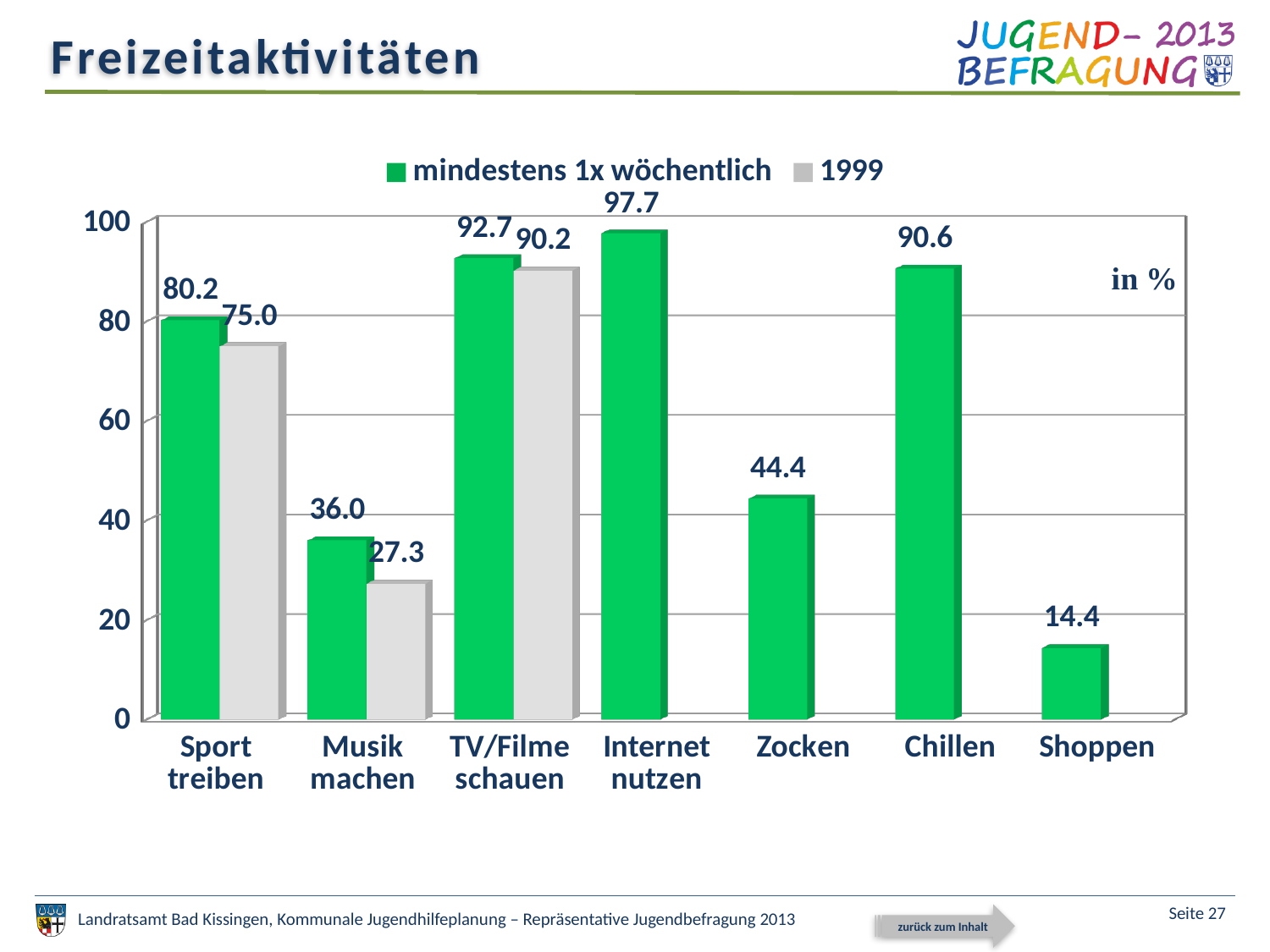
How many series does the legend list? 2 What kind of chart is shown on the slide? bar chart Is the value for 'Zocken' greater or less than 40? greater Which is larger for 'TV/Filme schauen': the 'mindestens 1x wöchentlich' value or the 1999 value? mindestens 1x wöchentlich Which category has the lowest value in the 'mindestens 1x wöchentlich' series? Shoppen Which colour represents the 1999 series? grey Which category has the highest value in the 'mindestens 1x wöchentlich' series? Internet nutzen What is the value for 'Sport treiben' in the 'mindestens 1x wöchentlich' series? 80.2 What is the difference between the 'mindestens 1x wöchentlich' value and the 1999 value for 'Sport treiben'? 5.2 What is the value for 'Internet nutzen' in the 'mindestens 1x wöchentlich' series? 97.7 What is the 1999 value for 'Musik machen'? 27.3 How many categories are shown on the x axis? 7